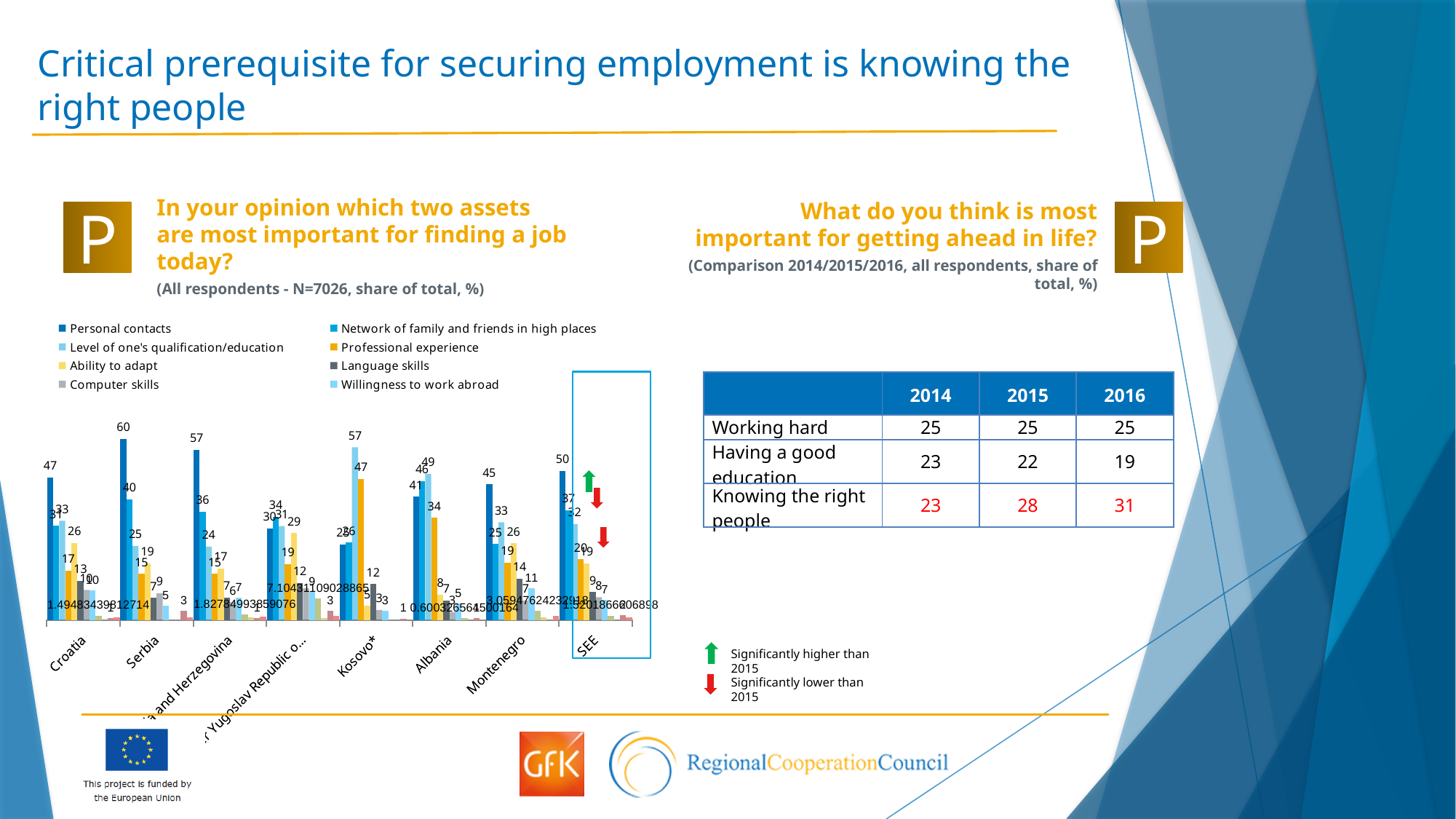
What is the sample size (N) stated in the subtitle of the bar chart? N=7026 What kind of chart is used to show which two assets are most important for finding a job today? bar chart How many countries/regions are shown along the x axis of the bar chart? 8 In the bar chart, which country has the highest value for Personal contacts? Serbia In the bar chart, what is the value for Personal contacts in Croatia? 47 How many series does the legend of the bar chart list? 8 In the bar chart, what is the value for Level of one's qualification/education in Kosovo*? 57 In the bar chart, what is the value for Personal contacts for SEE? 50 In the bar chart, what is the difference between the Personal contacts value for Serbia and for Croatia? 13 In the bar chart, what is the value for Personal contacts in Montenegro? 45 In the bar chart, what is the value for Personal contacts in Serbia? 60 In the bar chart, which is larger for Kosovo*: Personal contacts or Level of one's qualification/education? Level of one's qualification/education